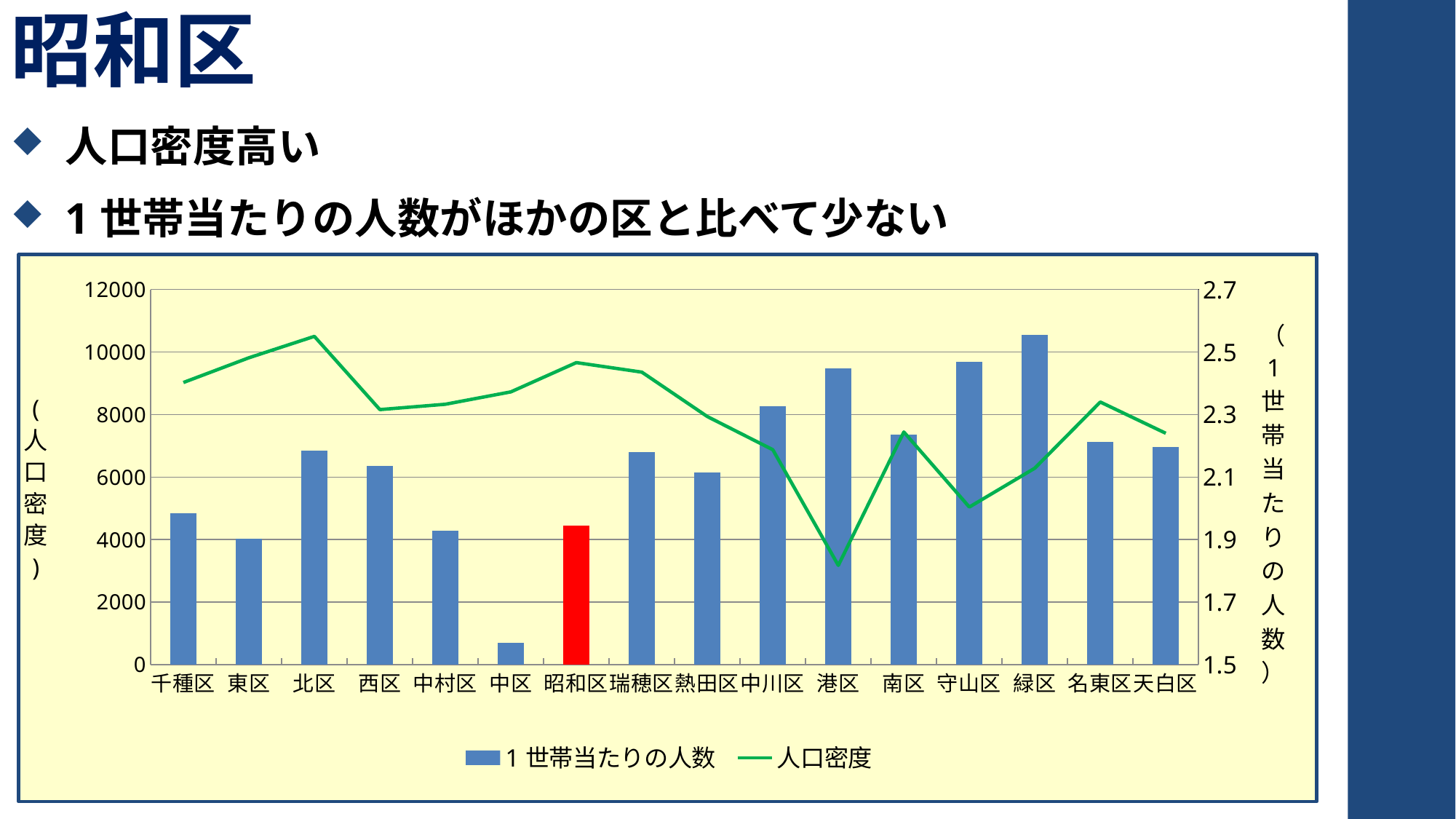
How many wards (categories) are shown on the x axis? 16 Which ward has the lowest point on the green line (人口密度)? 港区 How many series does the legend list? 2 What kind of chart is shown on the slide? Combined bar and line chart Which ward's bar is coloured red instead of blue? 昭和区 Which ward has the highest point on the green line (人口密度)? 北区 Which ward has the shortest bar? 中区 Which ward has the taller bar, 北区 or 西区? 北区 Which ward has the tallest bar? 緑区